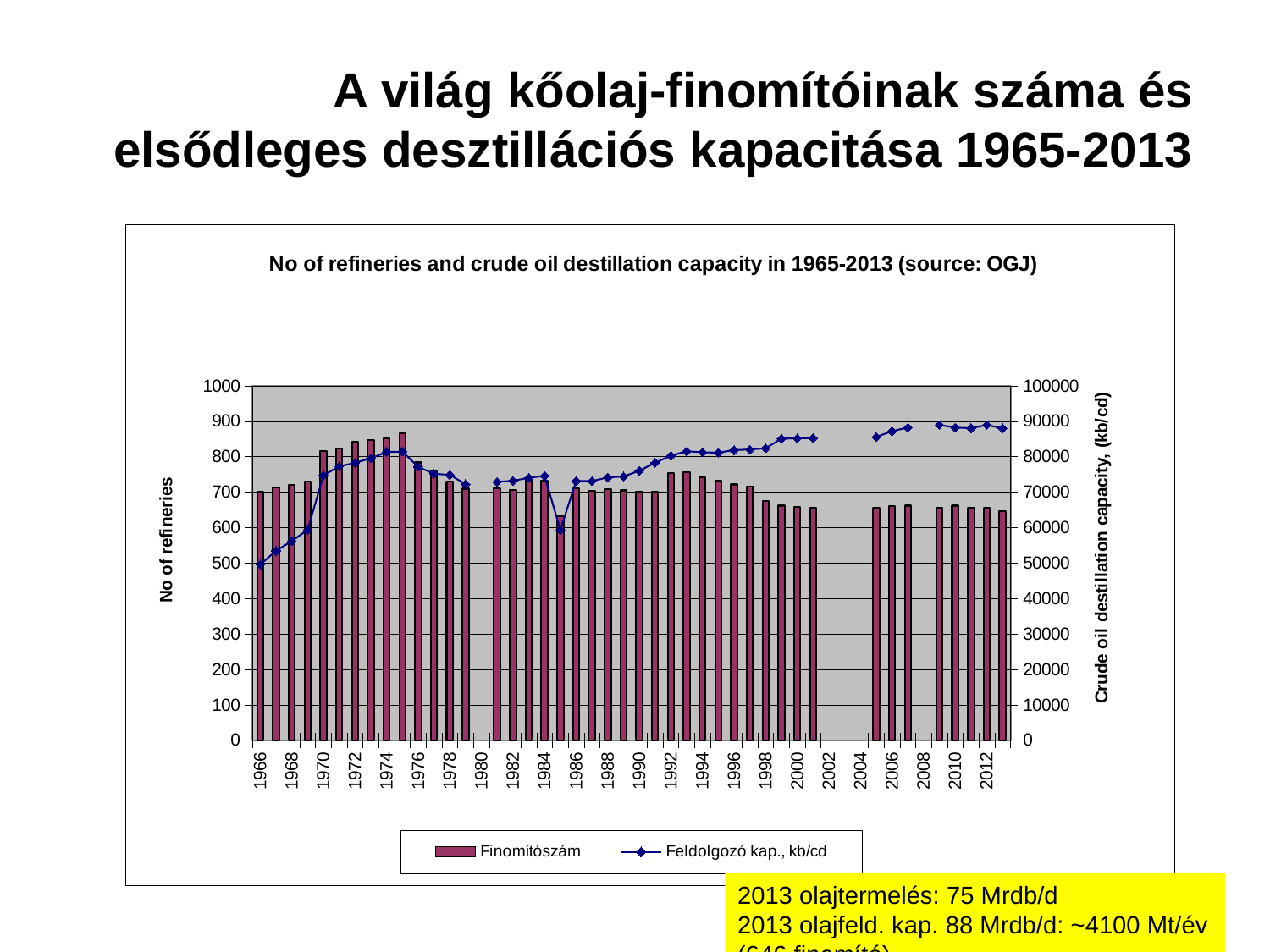
Is the crude oil distillation capacity (line) for 2013 greater or less than 80000? greater What is the label of the left vertical axis? No of refineries Is the crude oil distillation capacity (line) for 1966 greater or less than 60000? less Which year has the larger number of refineries (bar), 1975 or 2013? 1975 Is the number of refineries (bar) for 2013 greater or less than 700? less What kind of chart is shown on the slide? A combined bar and line chart What are the two series named in the legend? Finomítószám and Feldolgozó kap., kb/cd How many series does the chart legend list? 2 Does the crude oil distillation capacity line generally rise or fall from 1966 to 2013? rise